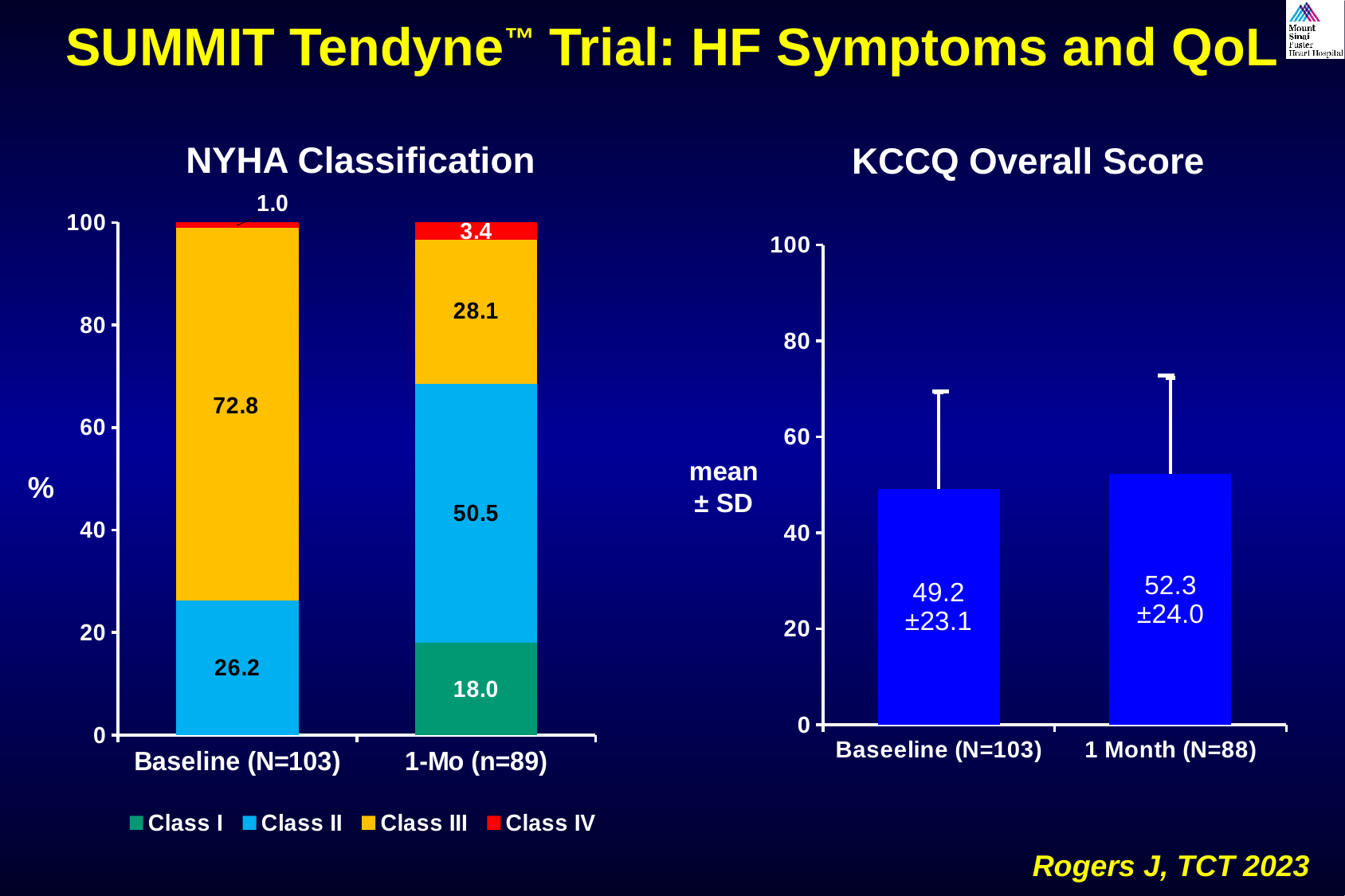
In the NYHA Classification chart, what is the Class IV percentage at Baseline (N=103)? 1.0 In the KCCQ Overall Score chart, what is the difference between the mean score at 1 Month and at Baseline? 3.1 What kind of chart is the KCCQ Overall Score chart? Bar chart In the NYHA Classification chart, which is larger: Class II at Baseline or Class II at 1-Mo? Class II at 1-Mo In the NYHA Classification chart, how many series does the legend list? 4 In the NYHA Classification chart, what is the Class I percentage at 1-Mo (n=89)? 18.0 In the KCCQ Overall Score chart, what is the SD at 1 Month (N=88)? 24.0 In the KCCQ Overall Score chart, what is the mean score at Baseline (N=103)? 49.2 In the NYHA Classification chart, what is the total of the 1-Mo (n=89) stacked bar? 100.0 In the NYHA Classification chart, what is the difference between the Class III percentage at Baseline and at 1-Mo? 44.7 In the NYHA Classification chart, what is the Class II percentage at 1-Mo (n=89)? 50.5 In the NYHA Classification chart, what is the Class III percentage at Baseline (N=103)? 72.8